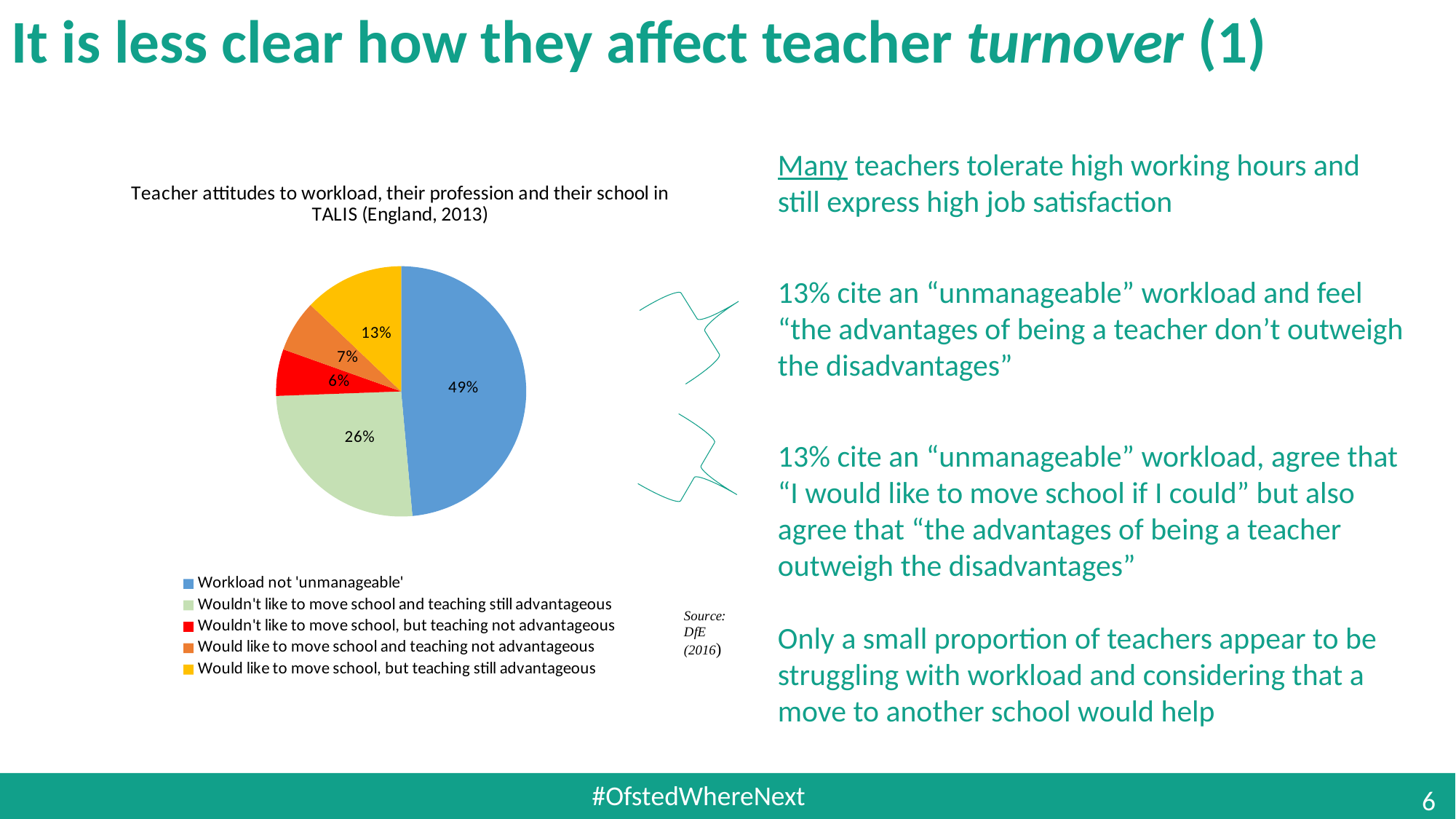
Which category has the largest slice of the pie? Workload not 'unmanageable' Which category has the smallest slice of the pie? Wouldn't like to move school, but teaching not advantageous How many categories does the pie chart legend list? 5 What share of the pie is 'Workload not 'unmanageable''? 49% What share of the pie is 'Wouldn't like to move school, but teaching not advantageous'? 6% What share of the pie is 'Would like to move school, but teaching still advantageous'? 13% What kind of chart is shown on the slide? Pie chart What is the title of the chart? Teacher attitudes to workload, their profession and their school in TALIS (England, 2013) What share of the pie is 'Would like to move school and teaching not advantageous'? 7% Which is larger: 'Would like to move school, but teaching still advantageous' or 'Would like to move school and teaching not advantageous'? Would like to move school, but teaching still advantageous What share of the pie is 'Wouldn't like to move school and teaching still advantageous'? 26% What is the difference in percentage points between 'Workload not 'unmanageable'' and 'Wouldn't like to move school and teaching still advantageous'? 23 percentage points